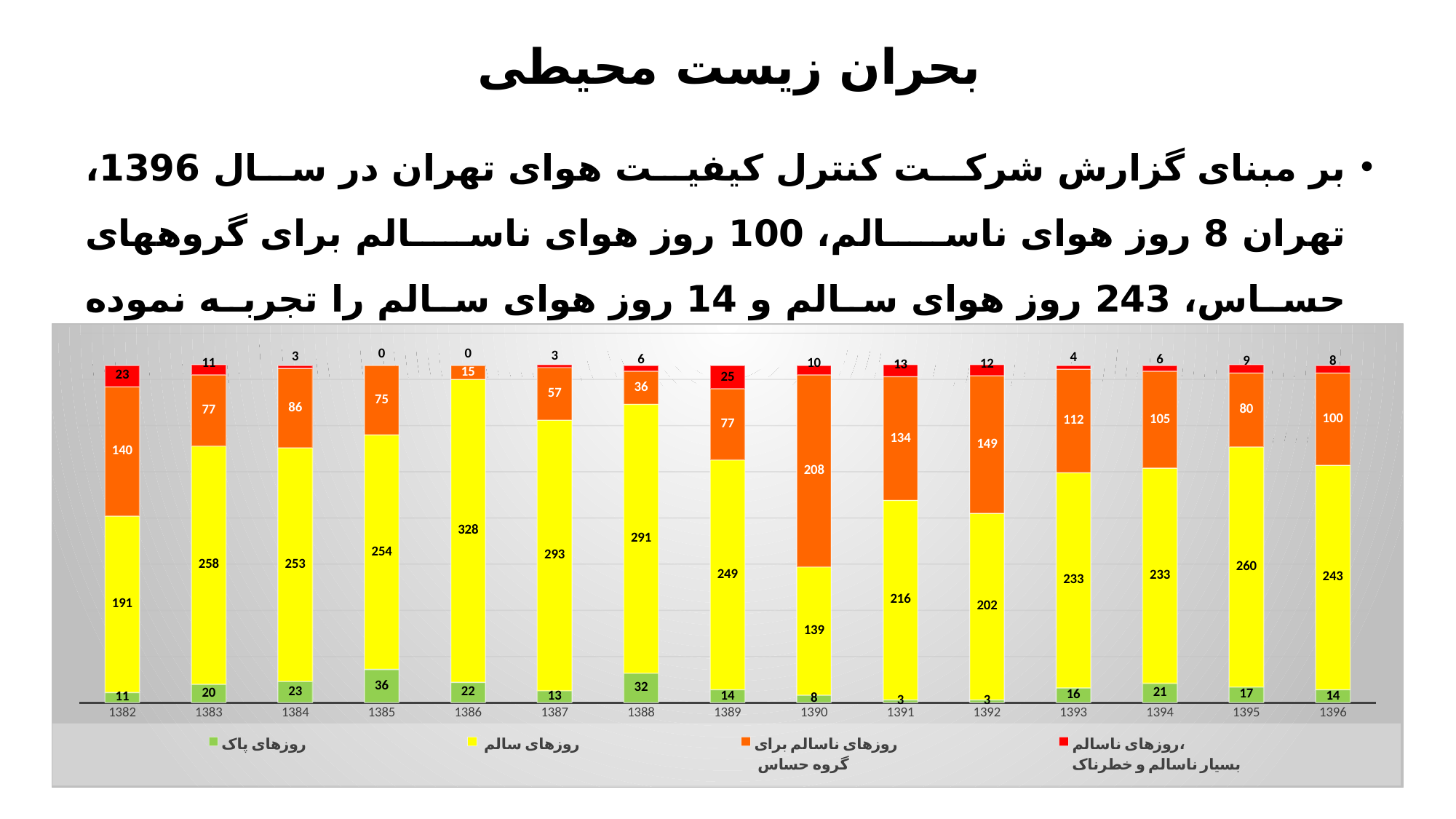
What type of chart is shown on the slide? stacked bar chart How many years (categories) are shown on the x axis of the chart? 15 What is the value of the red segment for the year 1389? 25 What is the value of the orange segment (روزهای ناسالم برای گروه حساس) for the year 1390? 208 What is the value of the yellow segment (روزهای سالم) for the year 1386? 328 Which year has the lowest value for the orange segment (روزهای ناسالم برای گروه حساس)? 1386 What is the total of the stacked bar for the year 1396? 365 Which is larger: the yellow segment for 1395 or the yellow segment for 1396? 1395 How many series does the chart's legend list? 4 What is the value of the green segment (روزهای پاک) for the year 1385? 36 What is the difference between the orange segment values for 1390 and 1396? 108 Which year has the highest value for the yellow segment (روزهای سالم)? 1386